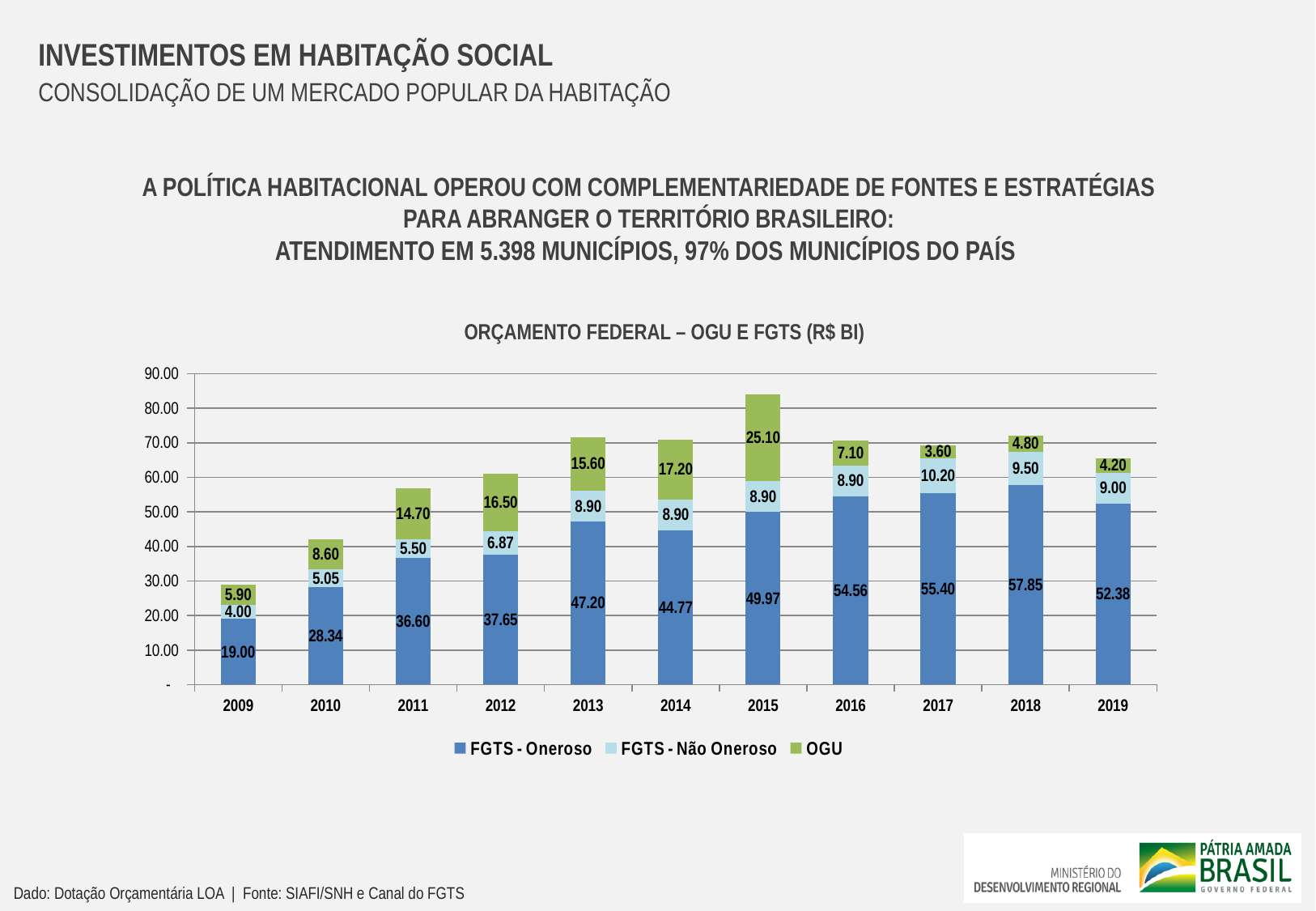
What is the difference between the FGTS - Oneroso values for 2018 and 2019? 5.47 What type of chart is shown on the slide? Stacked bar chart What is the total of the stacked bar for 2009? 28.90 What is the title of the chart? ORÇAMENTO FEDERAL – OGU E FGTS (R$ BI) In which year is the FGTS - Oneroso value lowest? 2009 What is the FGTS - Não Oneroso value for 2017? 10.20 What is the FGTS - Oneroso value for 2015? 49.97 Which is larger, the OGU value for 2013 or for 2014? 2014 How many series does the legend list? 3 In which year is the OGU value highest? 2015 What is the OGU value for 2012? 16.50 How many years are shown on the x axis? 11